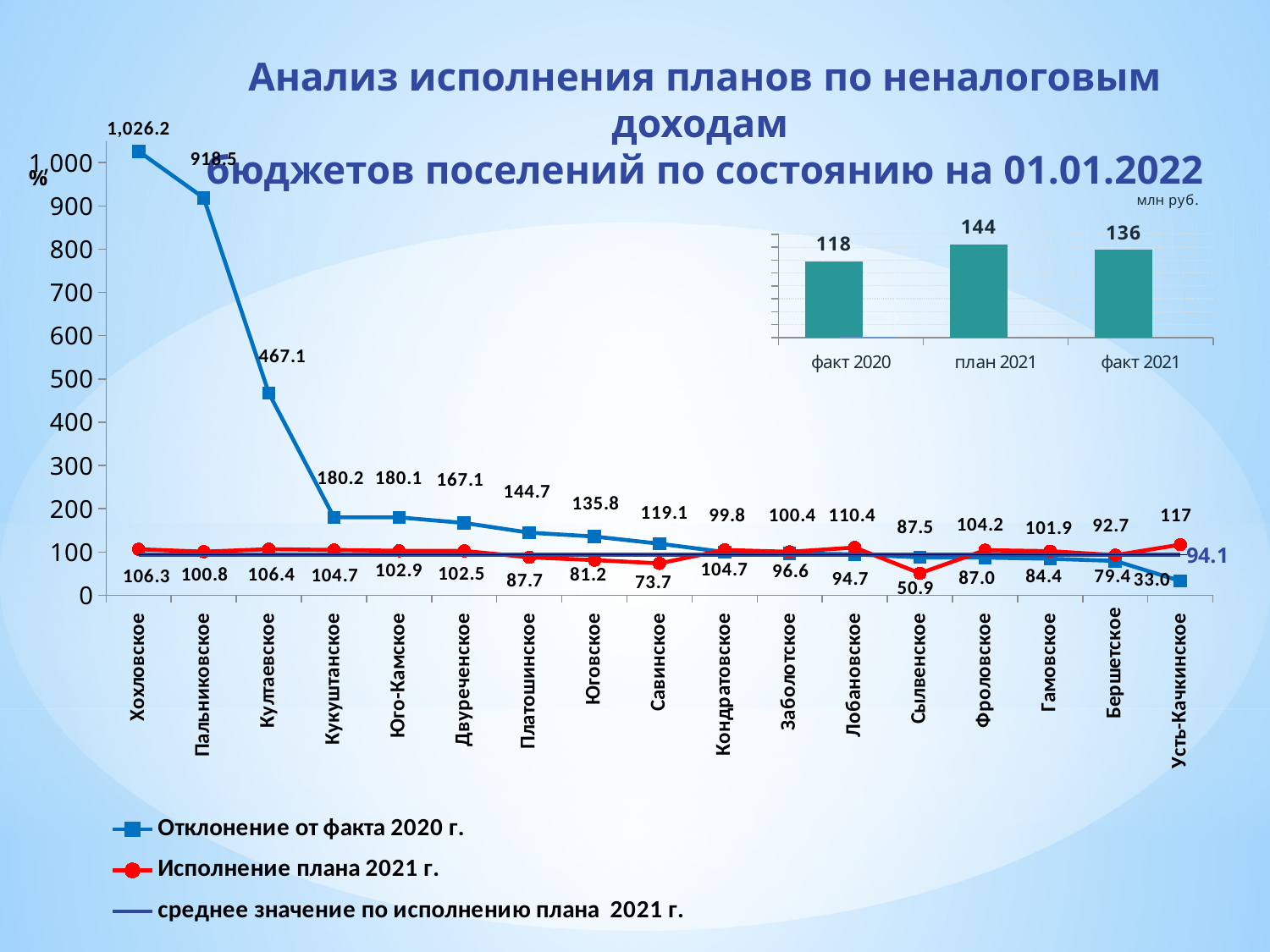
In the large line chart, does the Отклонение от факта 2020 г. series generally rise or fall from left to right? fall What kind of chart is the small chart at the top right of the slide? bar chart In the small bar chart at the top right, what is the difference between план 2021 and факт 2021? 8 In the large line chart, what is the value of среднее значение по исполнению плана 2021 г.? 94.1 In the small bar chart at the top right, which category has the highest value? план 2021 In the large line chart, what is the value of Исполнение плана 2021 г. for Сылвенское? 50.9 In the large line chart, which settlement has the lowest value for Исполнение плана 2021 г.? Сылвенское In the small bar chart at the top right, what is the value for план 2021? 144 In the large line chart, which is larger for Исполнение плана 2021 г.: Хохловское or Усть-Качкинское? Усть-Качкинское In the large line chart, what is the value of Отклонение от факта 2020 г. for Хохловское? 1,026.2 How many settlements are shown on the x axis of the large line chart? 17 How many series does the legend of the large line chart list? 3